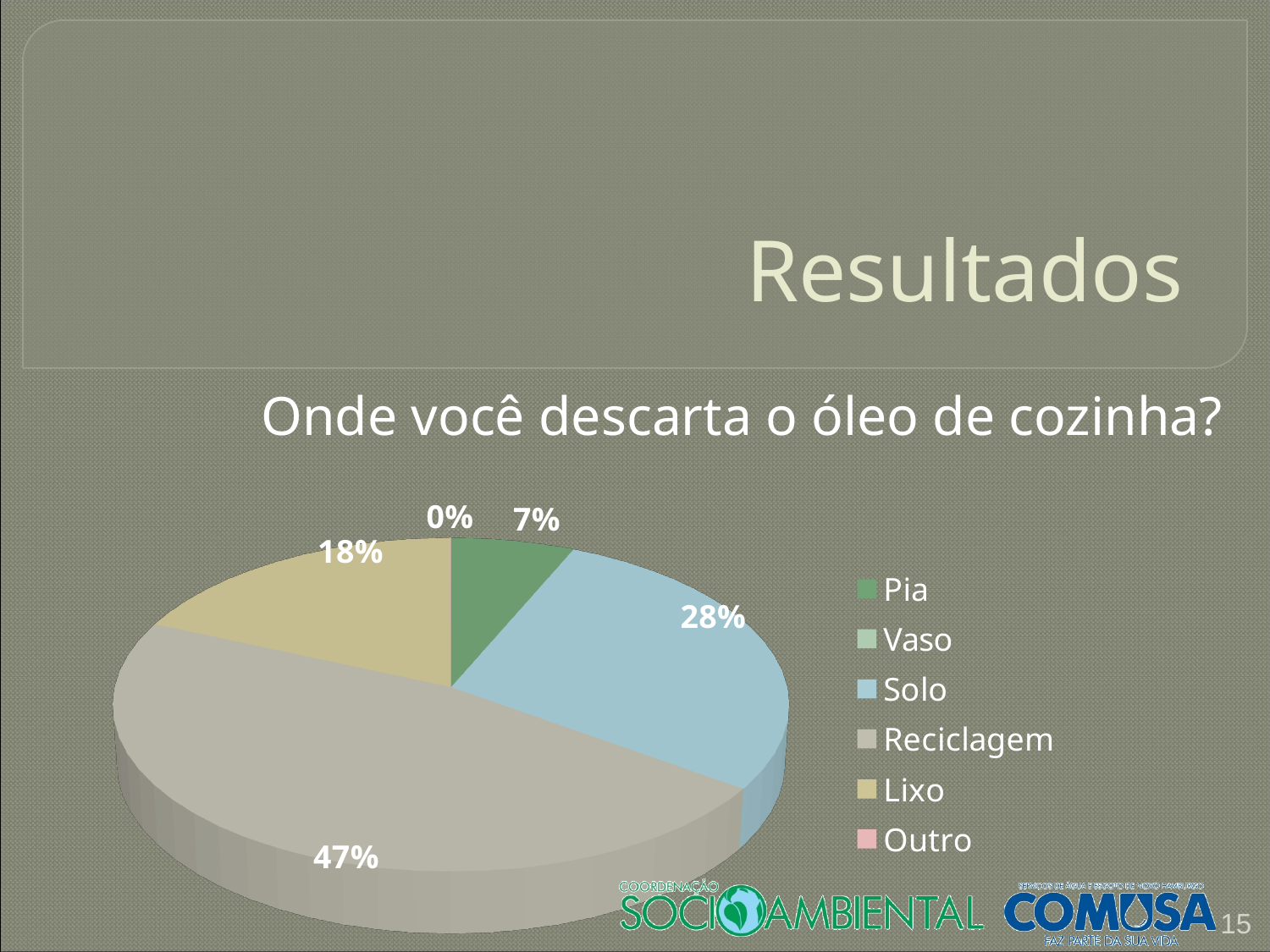
What type of chart is shown on the slide? Pie chart What is the difference in percentage points between Lixo and Pia? 11% What percentage is shown for Pia? 7% What is the difference in percentage points between Reciclagem and Solo? 19% What is the title of the chart? Onde você descarta o óleo de cozinha? What share of the pie does Lixo represent? 18% How many categories are listed in the chart legend? 6 Which is larger, the slice for Solo or the slice for Lixo? Solo What percentage of respondents discard cooking oil via Reciclagem? 47% What percentage is shown for Solo in the pie chart? 28% Which category has the largest slice of the pie chart? Reciclagem What is the combined percentage of Reciclagem and Solo? 75%